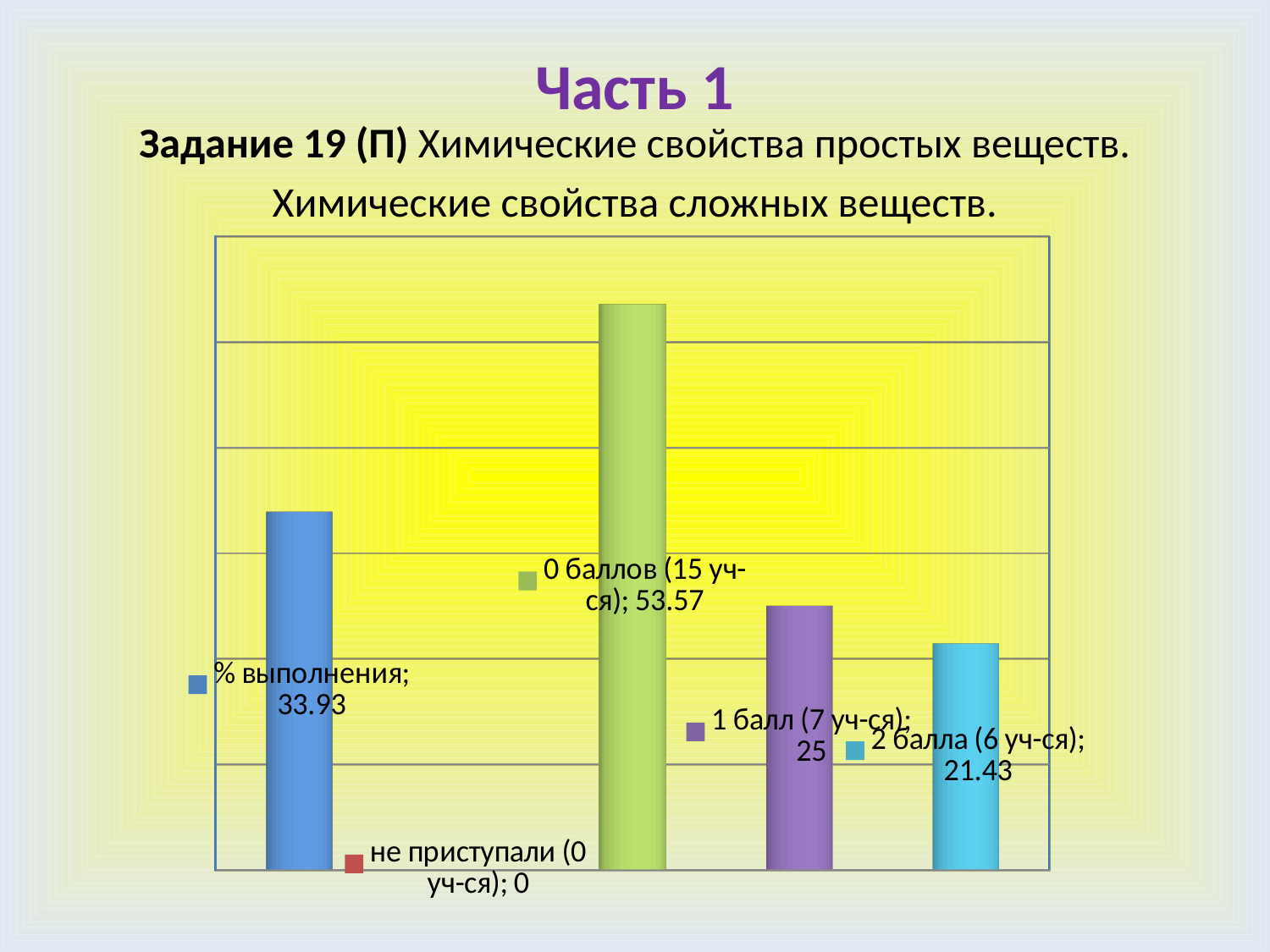
How many bars (categories) are plotted in the chart? 5 What is the value shown for "2 балла (6 уч-ся)"? 21.43 What is the value shown for "0 баллов (15 уч-ся)"? 53.57 What is the difference between the values for "0 баллов (15 уч-ся)" and "1 балл (7 уч-ся)"? 28.57 What is the value shown for "1 балл (7 уч-ся)"? 25 What is the value shown for "не приступали (0 уч-ся)"? 0 What kind of chart is shown on the slide? Bar chart Which category has the lowest value? не приступали (0 уч-ся) What colour is the bar for "0 баллов (15 уч-ся)"? Green Which is larger: the value for "% выполнения" or the value for "2 балла (6 уч-ся)"? % выполнения What is the value shown for "% выполнения"? 33.93 Which category has the highest value? 0 баллов (15 уч-ся)